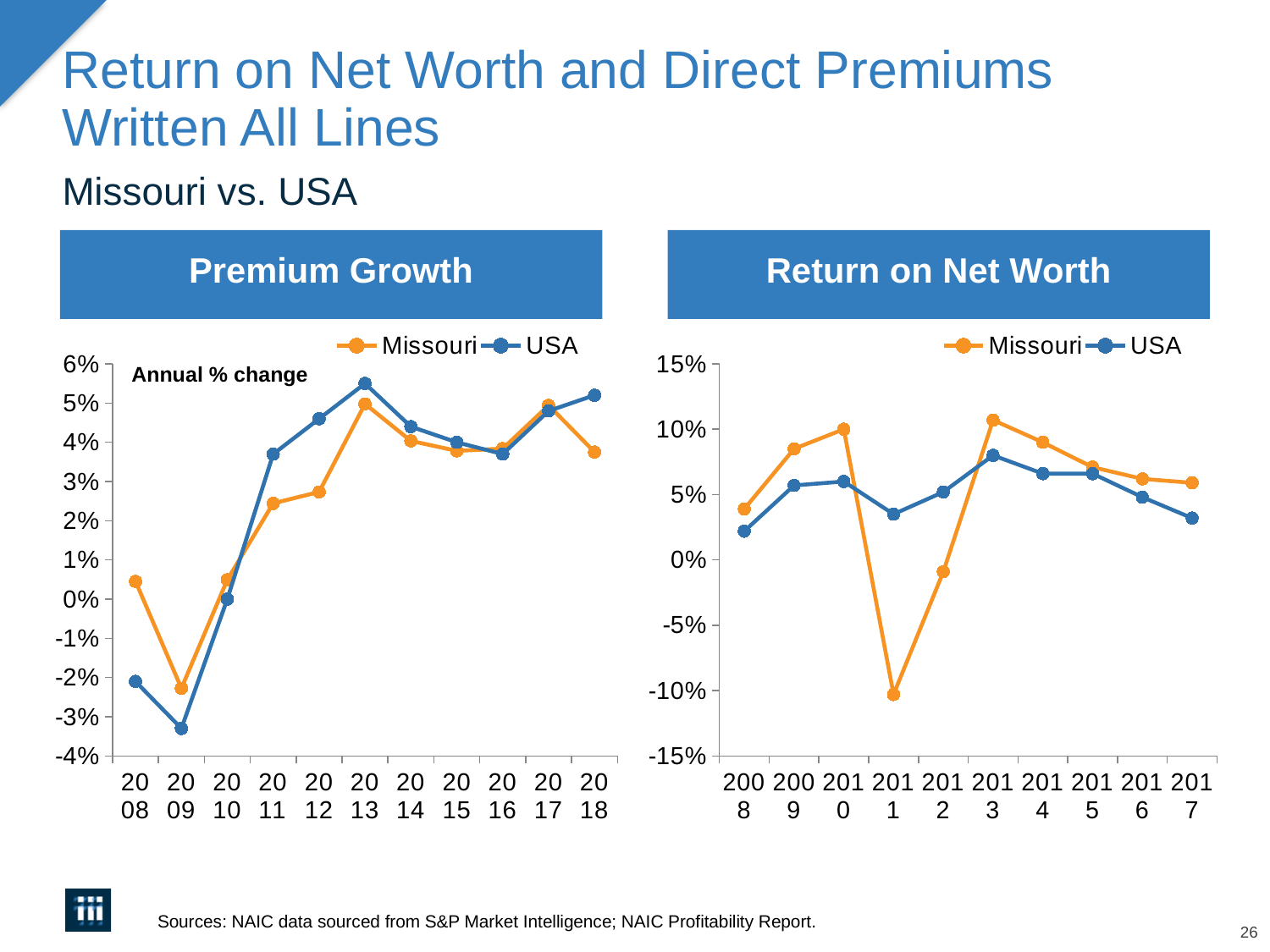
In the Premium Growth chart, which year has the highest value for USA? 2013 In the Premium Growth chart, is the value for USA in 2009 greater or less than -2%? less In the Return on Net Worth chart, which year has the lowest value for Missouri? 2011 How many series does the legend of the Return on Net Worth chart list? 2 In the Return on Net Worth chart, which year has the highest value for USA? 2013 In the Return on Net Worth chart, which is larger in 2011, Missouri or USA? USA In the Return on Net Worth chart, is the value for Missouri in 2011 greater or less than -5%? less In the Premium Growth chart, which year has the lowest value for Missouri? 2009 In the Premium Growth chart, is the value for USA in 2013 greater or less than 5%? greater How many years are plotted on the x axis of the Return on Net Worth chart? 10 How many years are plotted on the x axis of the Premium Growth chart? 11 What type of chart is the Premium Growth chart? line chart